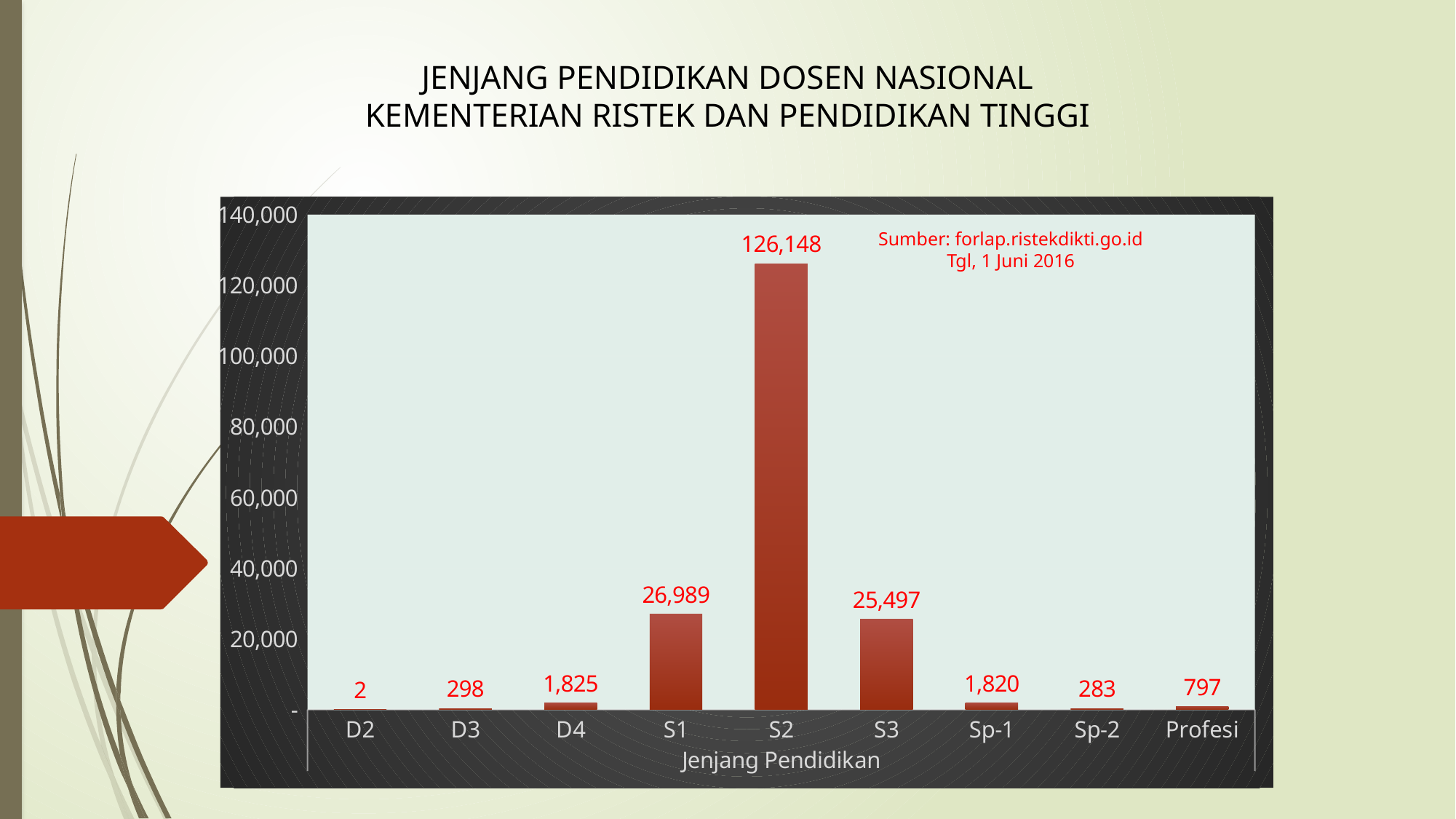
What is the value for S2? 126,148 Is the value for S3 greater or less than 20,000? greater Which category has the lowest value? D2 What is the value for S1? 26,989 What is the value for Sp-1? 1,820 Which category has the highest value? S2 What is the value for Profesi? 797 What is the x-axis title of the chart? Jenjang Pendidikan Which is larger, the value for D4 or the value for Sp-1? D4 What is the difference between the values for S1 and S3? 1,492 What kind of chart is shown? bar chart How many categories are shown on the x axis? 9